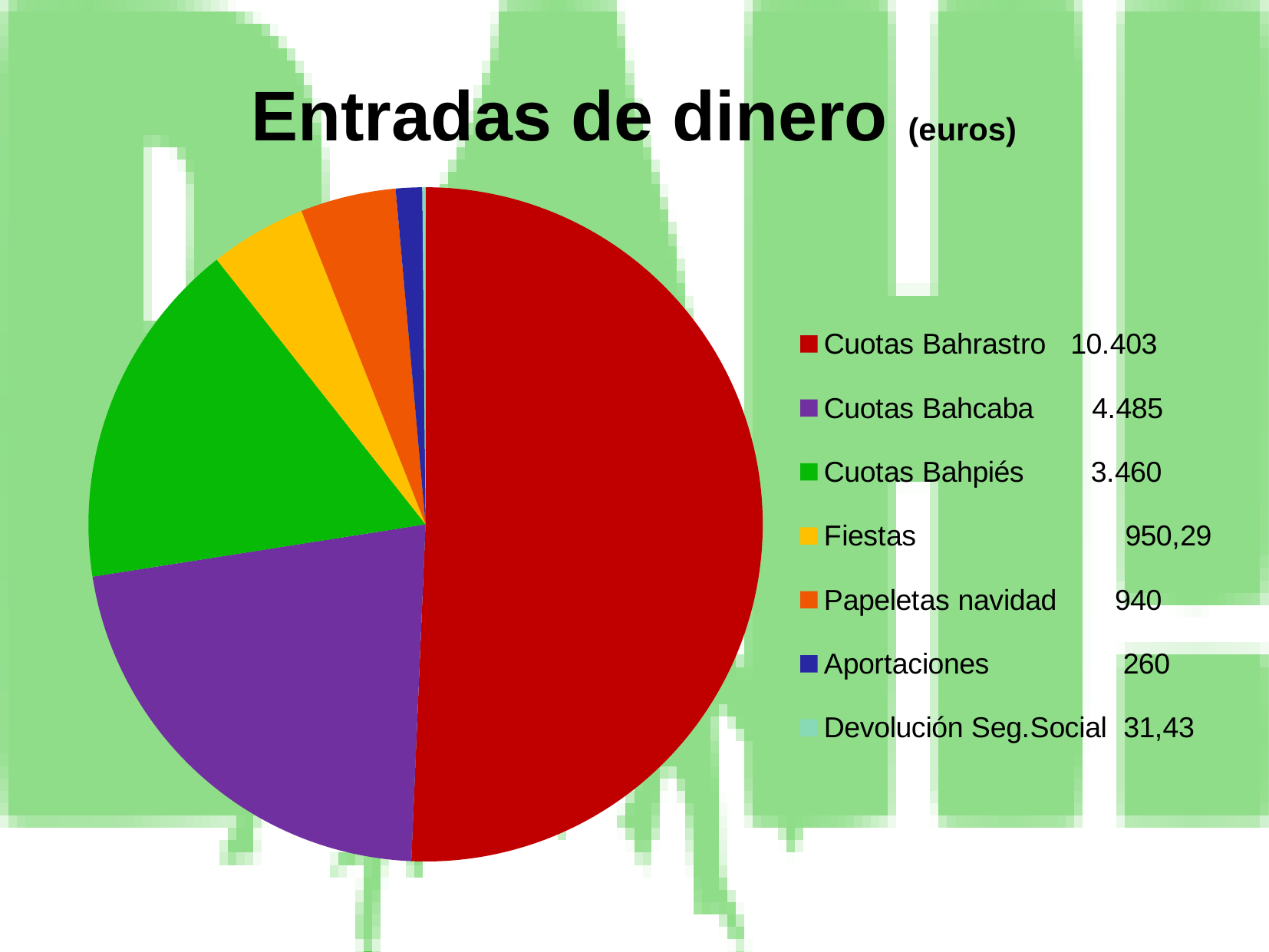
What is the value for Fiestas? 950,29 What is the value for Devolución Seg.Social? 31,43 Which is larger, Fiestas or Papeletas navidad? Fiestas What is the value for Cuotas Bahcaba? 4.485 Which is larger, Cuotas Bahcaba or Cuotas Bahpiés? Cuotas Bahcaba What is the value for Cuotas Bahrastro? 10.403 Which category has the largest value? Cuotas Bahrastro What is the difference between Papeletas navidad and Aportaciones? 680 How many categories does the pie chart have? 7 Which category has the smallest value? Devolución Seg.Social What type of chart is shown on the slide? Pie chart What is the title of the chart? Entradas de dinero (euros)